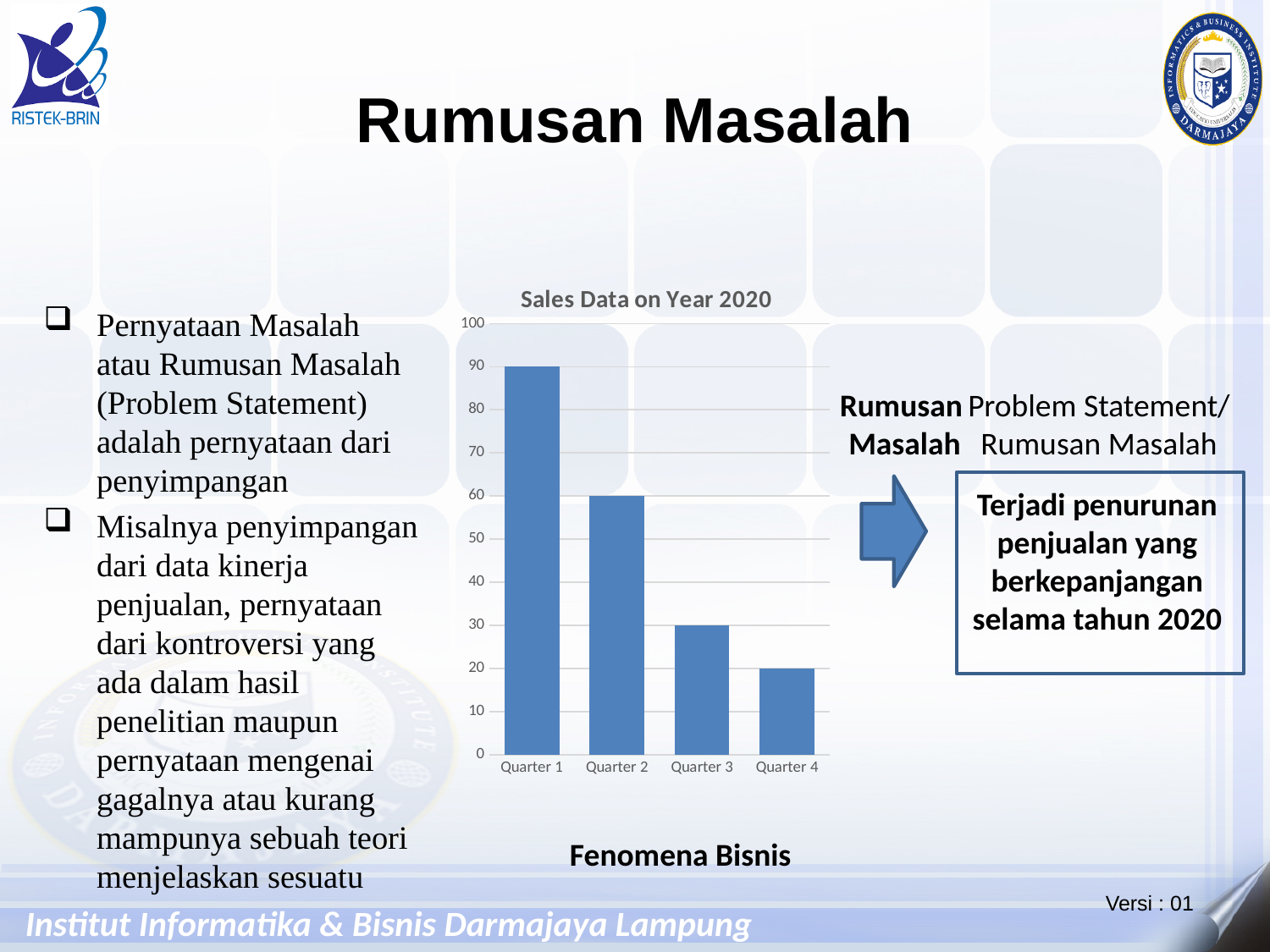
Which is larger, the value for Quarter 2 or the value for Quarter 3? Quarter 2 What kind of chart is shown on the slide? bar chart What is the sales value for Quarter 3? 30 Which quarter has the lowest sales value? Quarter 4 What is the title of the chart? Sales Data on Year 2020 How many quarters are plotted in the chart? 4 Do the sales values rise or fall from Quarter 1 to Quarter 4? fall What is the sales value for Quarter 1? 90 Which quarter has the highest sales value? Quarter 1 Is the value for Quarter 1 greater or less than 80? greater What is the sales value for Quarter 4? 20 What is the sales value for Quarter 2? 60